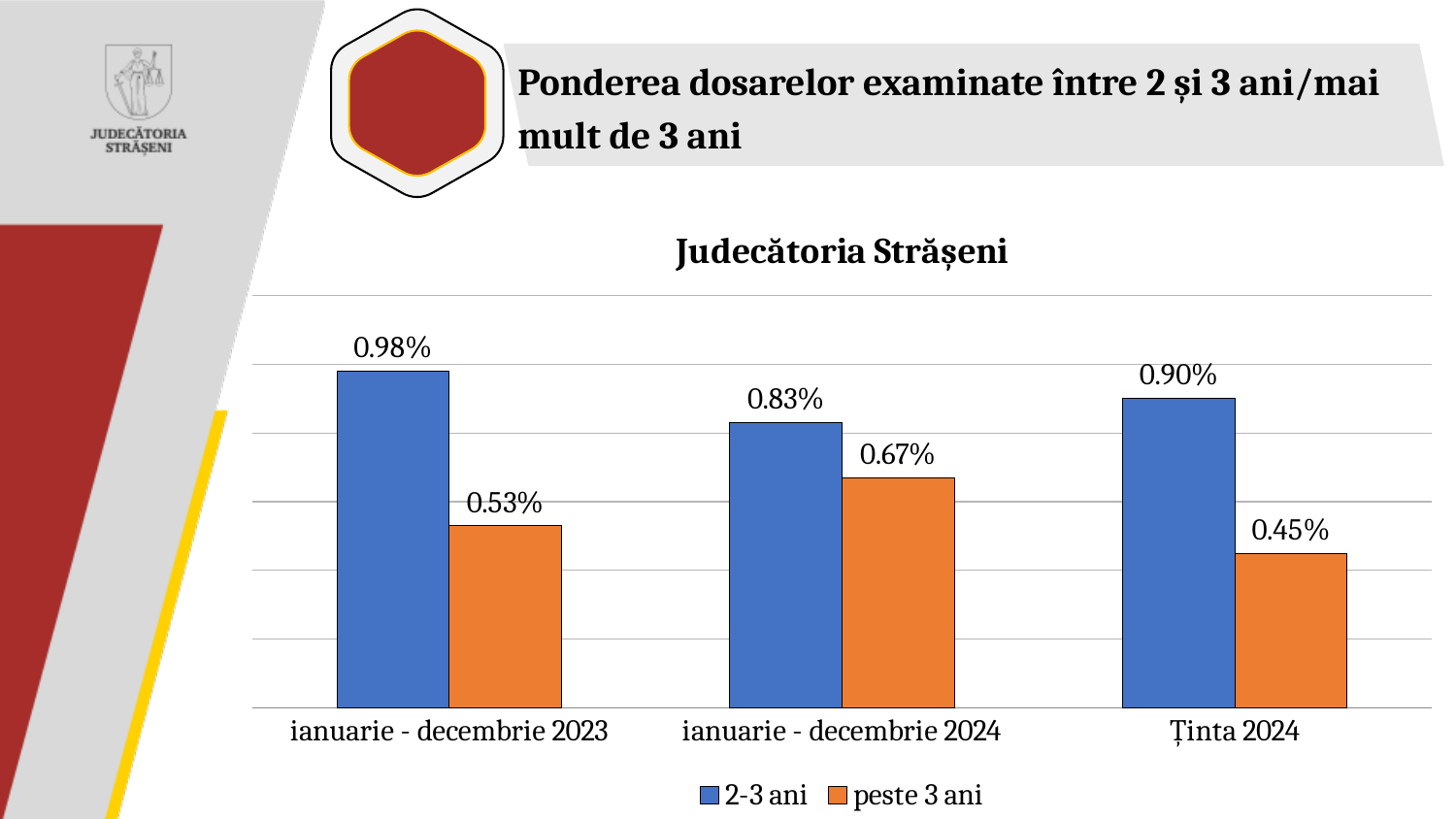
What is the difference between the '2-3 ani' and 'peste 3 ani' values in 'ianuarie - decembrie 2023'? 0.45% Which is larger: the '2-3 ani' value for 'ianuarie - decembrie 2024' or for 'Ținta 2024'? Ținta 2024 What is the value for 'peste 3 ani' in 'ianuarie - decembrie 2024'? 0.67% How many series does the legend list? 2 Which colour represents the 'peste 3 ani' series? orange How many categories are shown on the x axis? 3 Which category has the lowest value for 'peste 3 ani'? Ținta 2024 What is the value for 'peste 3 ani' in 'Ținta 2024'? 0.45% What kind of chart is shown on the slide? bar chart What is the title of the chart? Judecătoria Strășeni Which category has the highest value for '2-3 ani'? ianuarie - decembrie 2023 What is the value for '2-3 ani' in 'ianuarie - decembrie 2023'? 0.98%